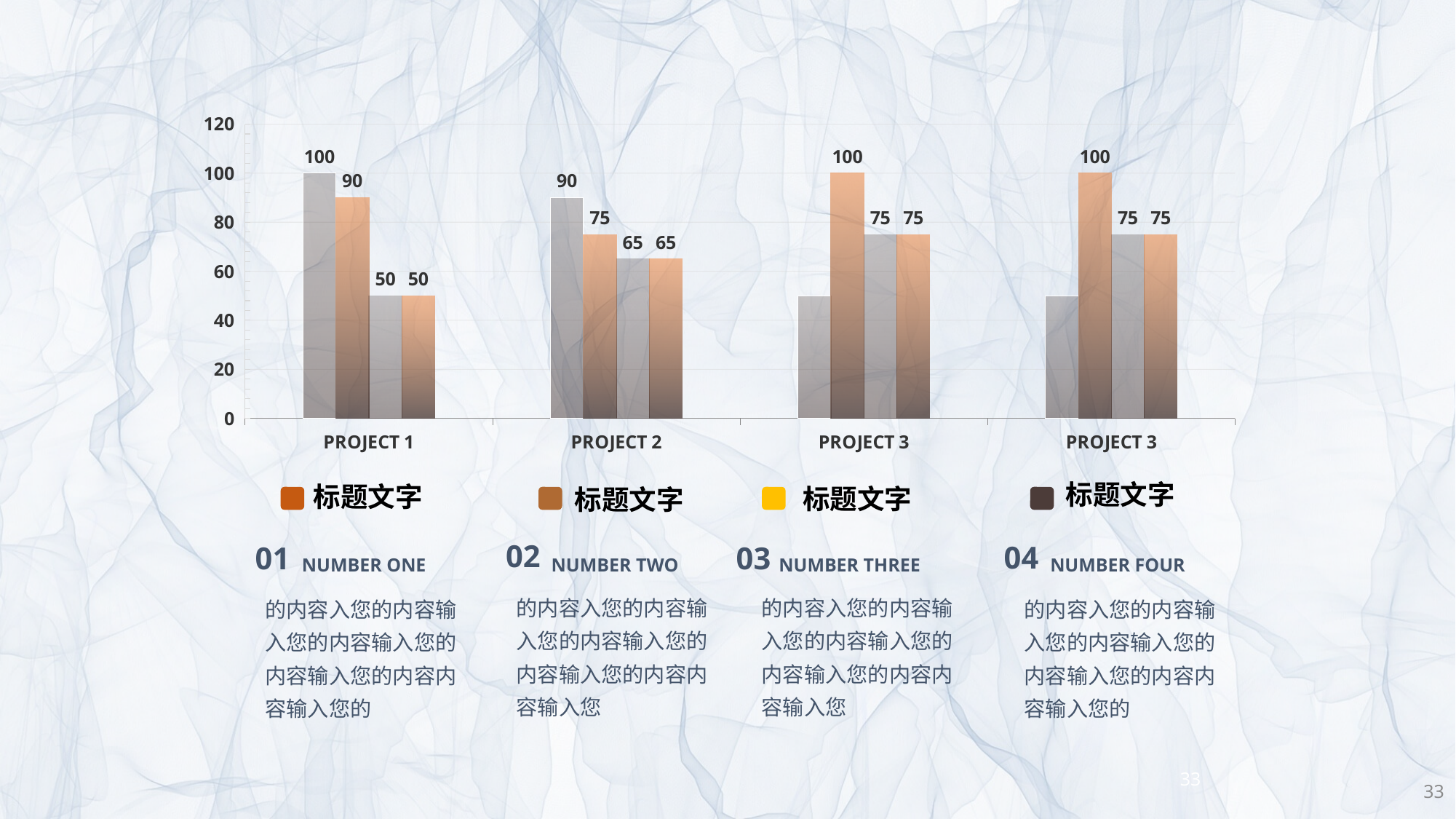
How many category groups are shown on the x axis? 4 What is the value of the leftmost bar in the PROJECT 1 group? 100 Is the value of the leftmost bar in the third group from the left greater or less than 60? less Which is larger: the second bar in the PROJECT 1 group or the second bar in the PROJECT 2 group? PROJECT 1 What is the difference between the first and second bars in the PROJECT 1 group? 10 What is the difference between the first bar (90) and the third bar (65) in the PROJECT 2 group? 25 What type of chart is shown on the slide? bar chart What is the highest value labelled in the PROJECT 2 group? 90 What is the value of the second bar from the left in the PROJECT 2 group? 75 What is the lowest value labelled in the PROJECT 1 group? 50 What is the value of the tallest bar in the third group from the left (labelled PROJECT 3)? 100